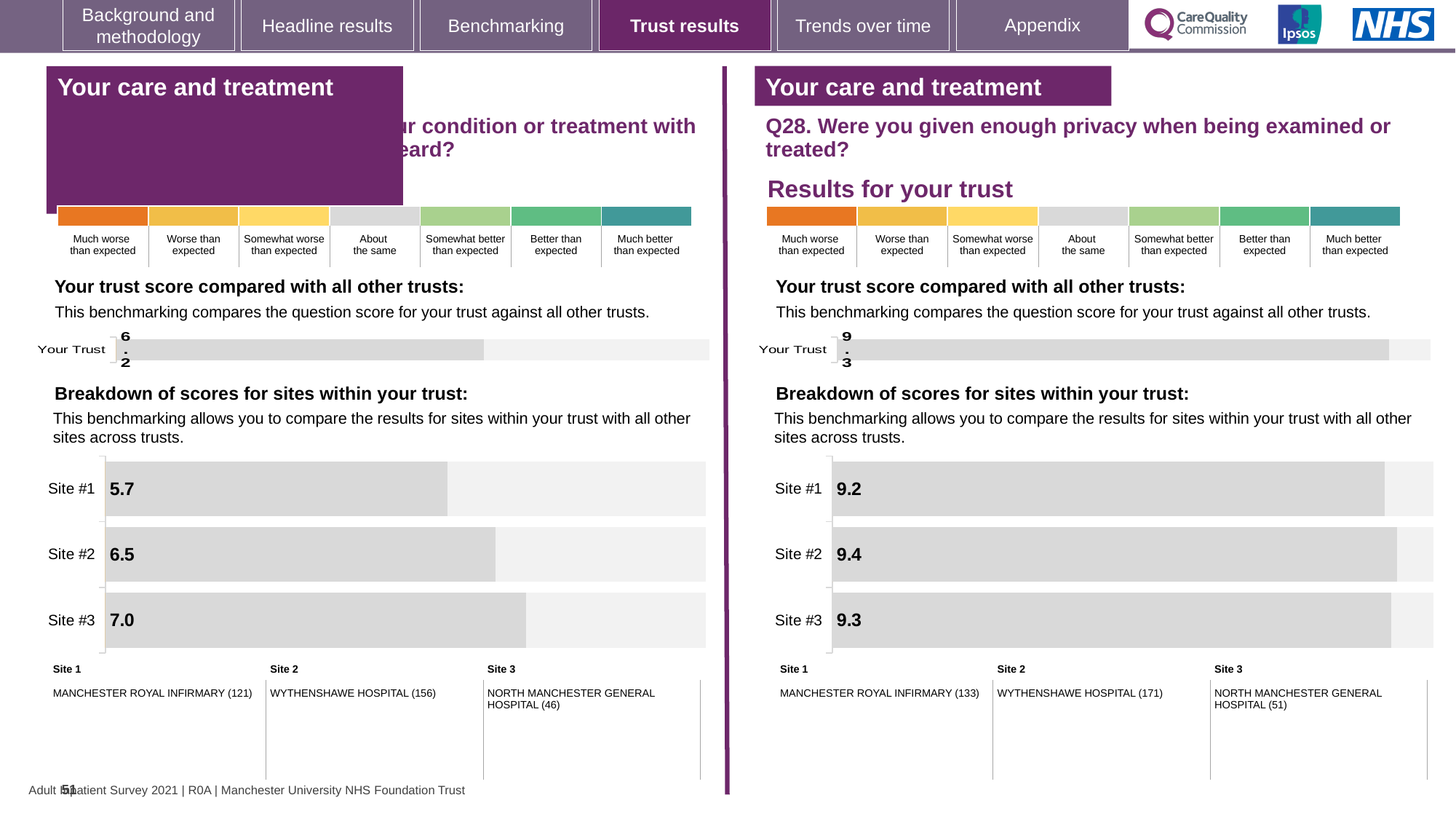
On the left-hand slide's 'Your trust score compared with all other trusts' chart, what is the score for Your Trust? 6.2 On the left-hand slide's site breakdown chart, which site has the lowest score? Site #1 On the Q28 (privacy) slide's 'Your trust score compared with all other trusts' chart, what is the score for Your Trust? 9.3 On the left-hand slide's site breakdown chart, which site has the highest score? Site #3 On the left-hand slide's site breakdown chart, what is the score for Site #3? 7.0 On the Q28 (privacy) slide's site breakdown chart, which site has the lowest score? Site #1 On the Q28 (privacy) slide's site breakdown chart, what is the score for Site #3? 9.3 On the Q28 (privacy) slide's site breakdown chart, what is the difference between the scores for Site #2 and Site #1? 0.2 On the Q28 (privacy) slide's site breakdown chart, what is the score for Site #2? 9.4 How many sites are shown in the site breakdown chart on the Q28 (privacy) slide? 3 On the left-hand slide's site breakdown chart, what is the difference between the scores for Site #3 and Site #1? 1.3 On the left-hand slide's site breakdown chart, what is the score for Site #1? 5.7